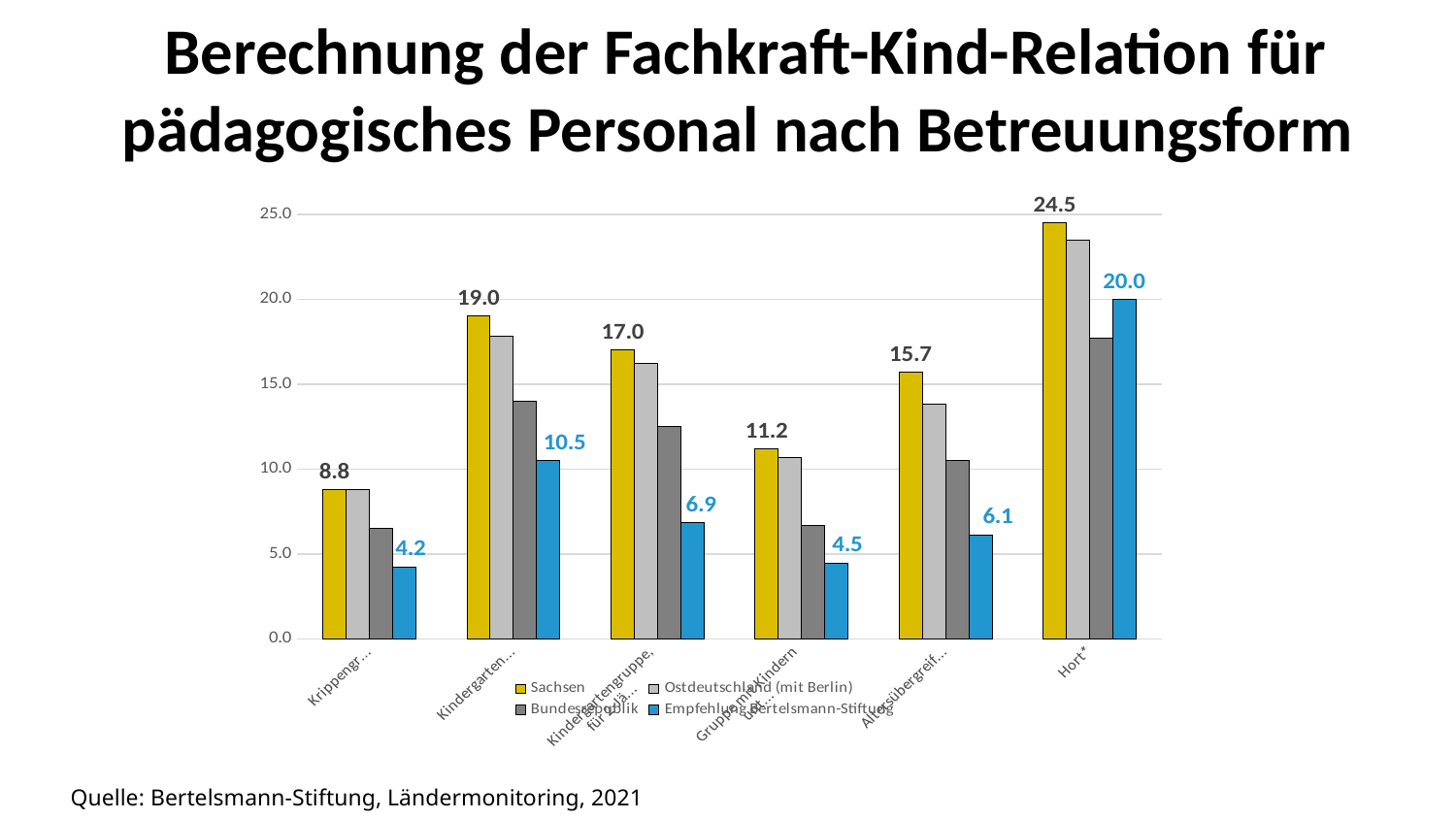
What is the difference between the Sachsen value and the Empfehlung Bertelsmann-Stiftung value in the Hort* category? 4.5 How many categories are shown on the x axis of the chart? 6 In the Hort* category, which is larger: the Sachsen value or the Empfehlung Bertelsmann-Stiftung value? Sachsen Is the value for Bundesrepublik in the Hort* category greater or less than 20.0? less What kind of chart is shown on the slide? Bar chart In which category does the Sachsen series reach its highest value? Hort* How many series does the chart legend list? 4 What is the value for Empfehlung Bertelsmann-Stiftung in the Hort* category? 20.0 What is the highest value shown for the Sachsen series? 24.5 What is the value for Sachsen in the Hort* category? 24.5 What is the lowest value shown for the Empfehlung Bertelsmann-Stiftung series? 4.2 Is the value for Ostdeutschland (mit Berlin) in the Hort* category greater or less than 20.0? greater